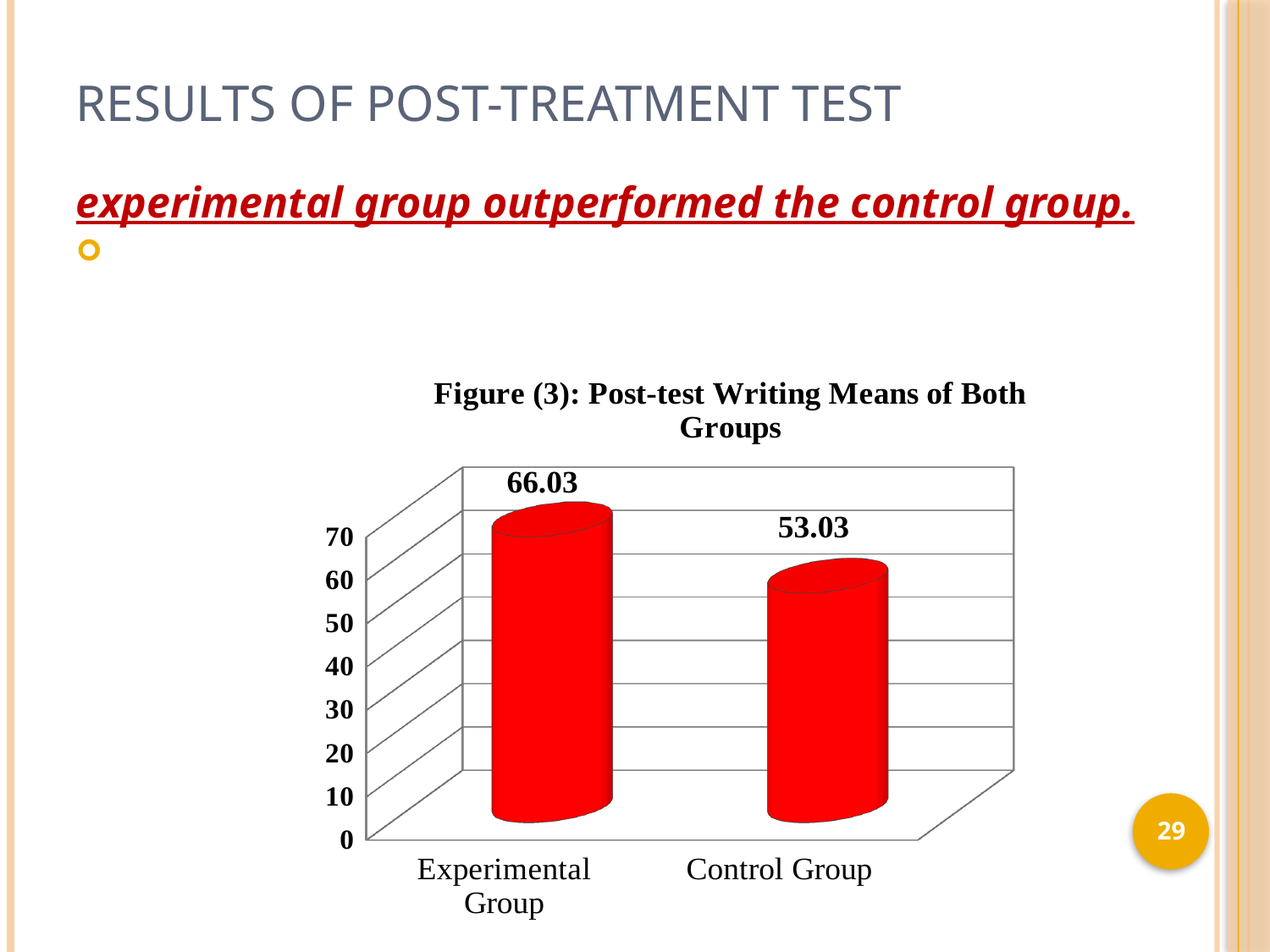
How many groups are shown in the chart? 2 What is the title of the chart? Figure (3): Post-test Writing Means of Both Groups What is the post-test writing mean for the Experimental Group? 66.03 What kind of chart is shown on the slide? bar chart Is the value for the Experimental Group larger or smaller than the value for the Control Group? larger What is the post-test writing mean for the Control Group? 53.03 Is the value for the Experimental Group greater or less than 60? greater Which group has the lower post-test writing mean? Control Group Is the value for the Control Group greater or less than 60? less What is the difference between the Experimental Group mean and the Control Group mean? 13.00 Which group has the higher post-test writing mean? Experimental Group What is the highest value shown on the vertical axis of the chart? 70